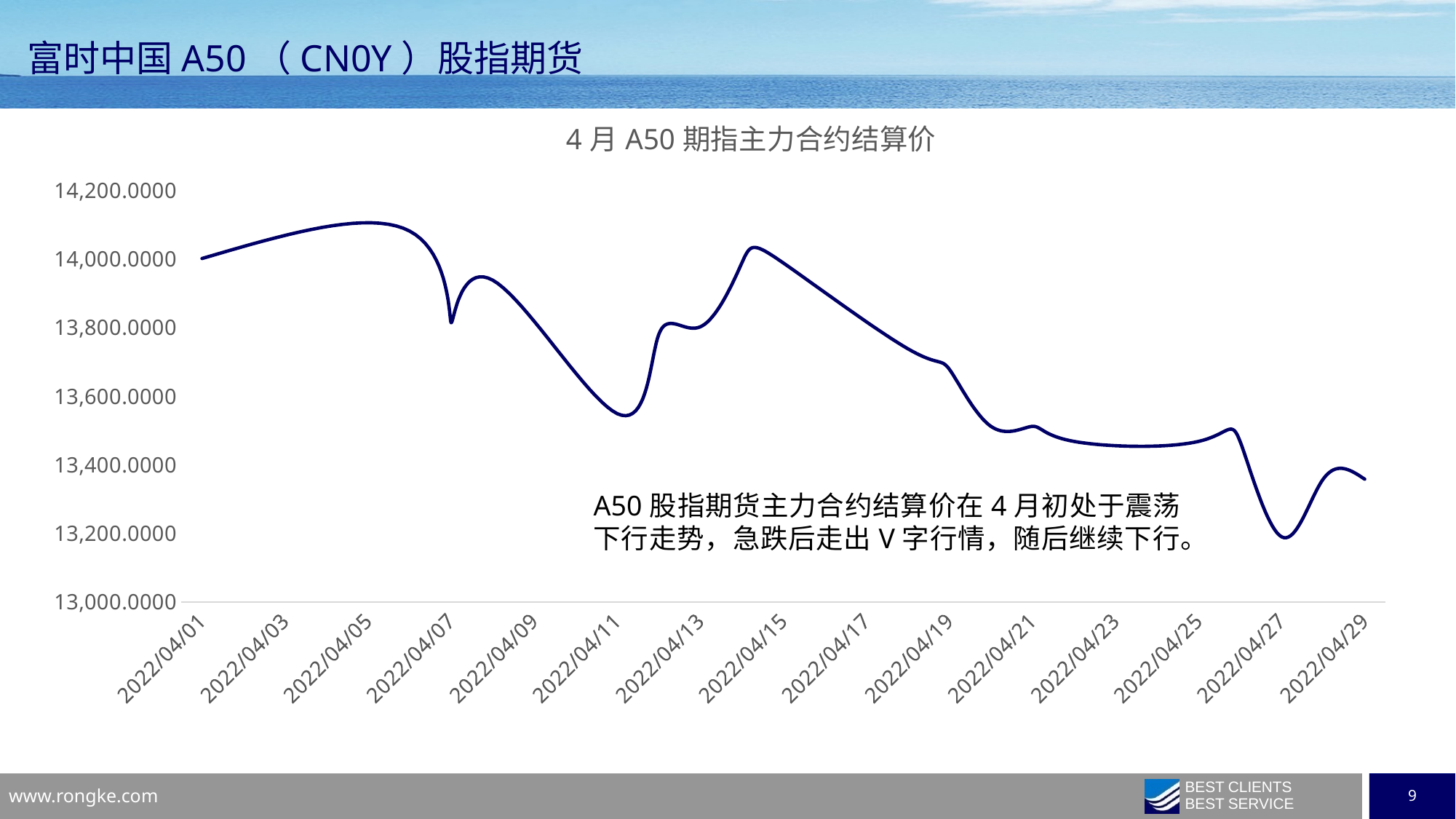
What is the title of the chart? 4 月 A50 期指主力合约结算价 Which is larger, the value for 2022/04/01 or the value for 2022/04/29? 2022/04/01 Is the value for 2022/04/29 greater or less than 13,400? less Which is larger, the value for 2022/04/05 or the value for 2022/04/21? 2022/04/05 Is the value for 2022/04/01 greater or less than 13,800? greater Is the value for 2022/04/23 greater or less than 13,600? less What is the lowest value shown on the y axis? 13,000.0000 Overall, does the settlement price rise or fall from 2022/04/01 to 2022/04/29? fall How many date labels are shown on the x axis? 15 What kind of chart is shown on the slide? line chart